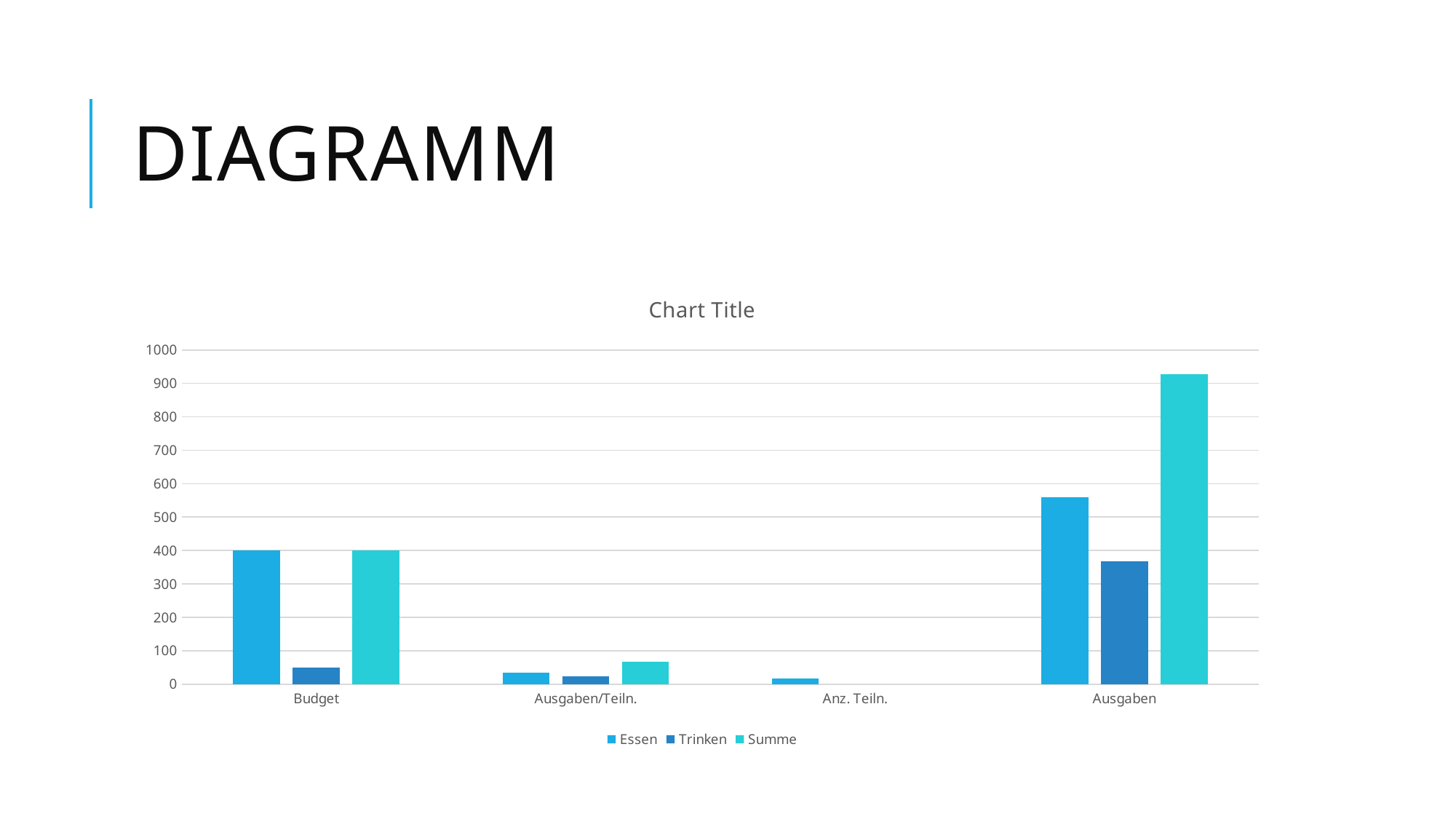
Is the value of Essen for Ausgaben greater or less than 500? greater What is the value of the Essen series for Budget? 400 How many series does the chart's legend list? 3 Is the value of Trinken for Budget greater or less than 100? less What kind of chart is shown on the slide? bar chart Which is larger for Ausgaben, the Essen value or the Trinken value? Essen Which category has the highest Summe value? Ausgaben What is the title of the chart? Chart Title Which category has the lowest Essen value? Anz. Teiln. What is the value of the Summe series for Budget? 400 How many categories are shown on the x axis of the chart? 4 Is the value of Summe for Ausgaben greater or less than 900? greater